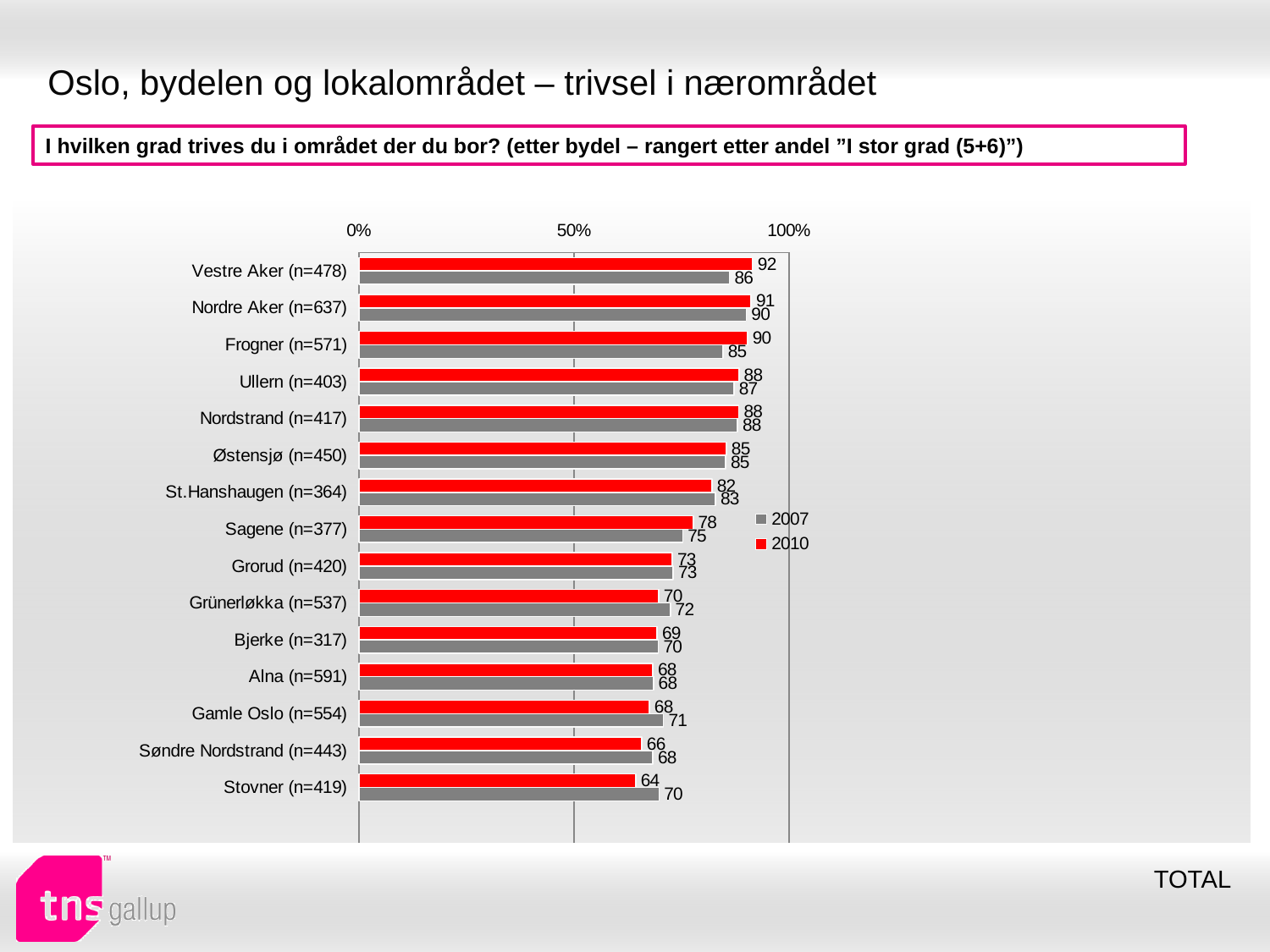
What is the difference between the 2010 and 2007 values for Vestre Aker (n=478)? 6 Which district has the highest 2010 value? Vestre Aker (n=478) Which is larger for Gamle Oslo (n=554): the 2007 value or the 2010 value? 2007 How many districts are shown in the chart? 15 Which district has the lowest 2010 value? Stovner (n=419) What is the difference between the 2007 and 2010 values for Stovner (n=419)? 6 Is the 2010 value for Grorud (n=420) greater or less than 50%? greater How many series does the legend list? 2 What is the 2007 value for Stovner (n=419)? 70 What type of chart is shown on the slide? Bar chart What is the 2007 value for Sagene (n=377)? 75 What is the 2010 value for Vestre Aker (n=478)? 92